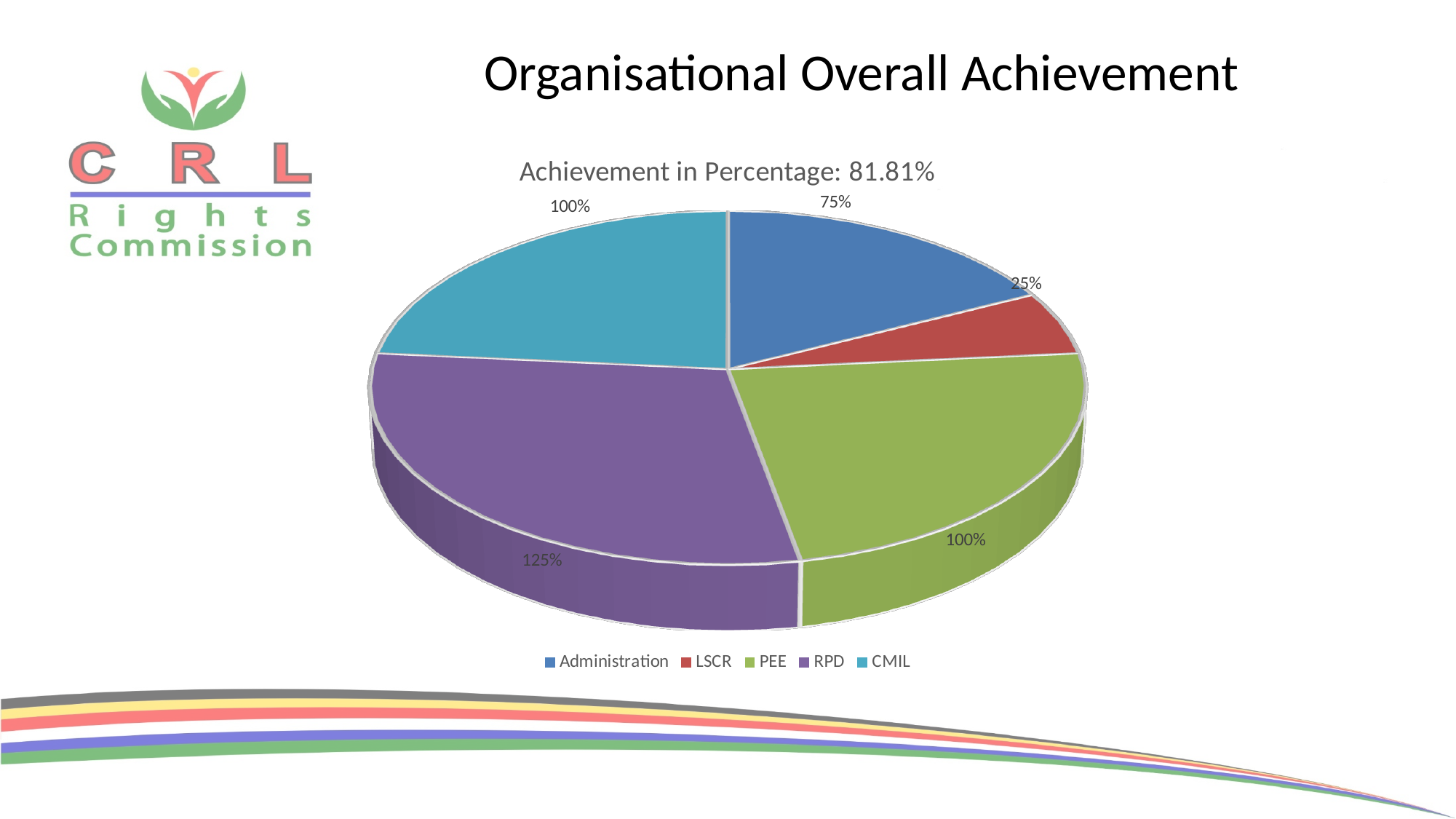
What is the value shown for LSCR in the pie chart? 25% What is the value shown for RPD in the pie chart? 125% What is the value shown for Administration in the pie chart? 75% What is the difference between the values for RPD and Administration? 50% What is the value shown for PEE in the pie chart? 100% What kind of chart is shown on the slide? Pie chart How many categories are shown in the pie chart? 5 Which has a larger value, Administration or LSCR? Administration What colour is the RPD slice in the pie chart? Purple Which category has the lowest value in the pie chart? LSCR Which category has the highest value in the pie chart? RPD What is the title of the chart? Achievement in Percentage: 81.81%